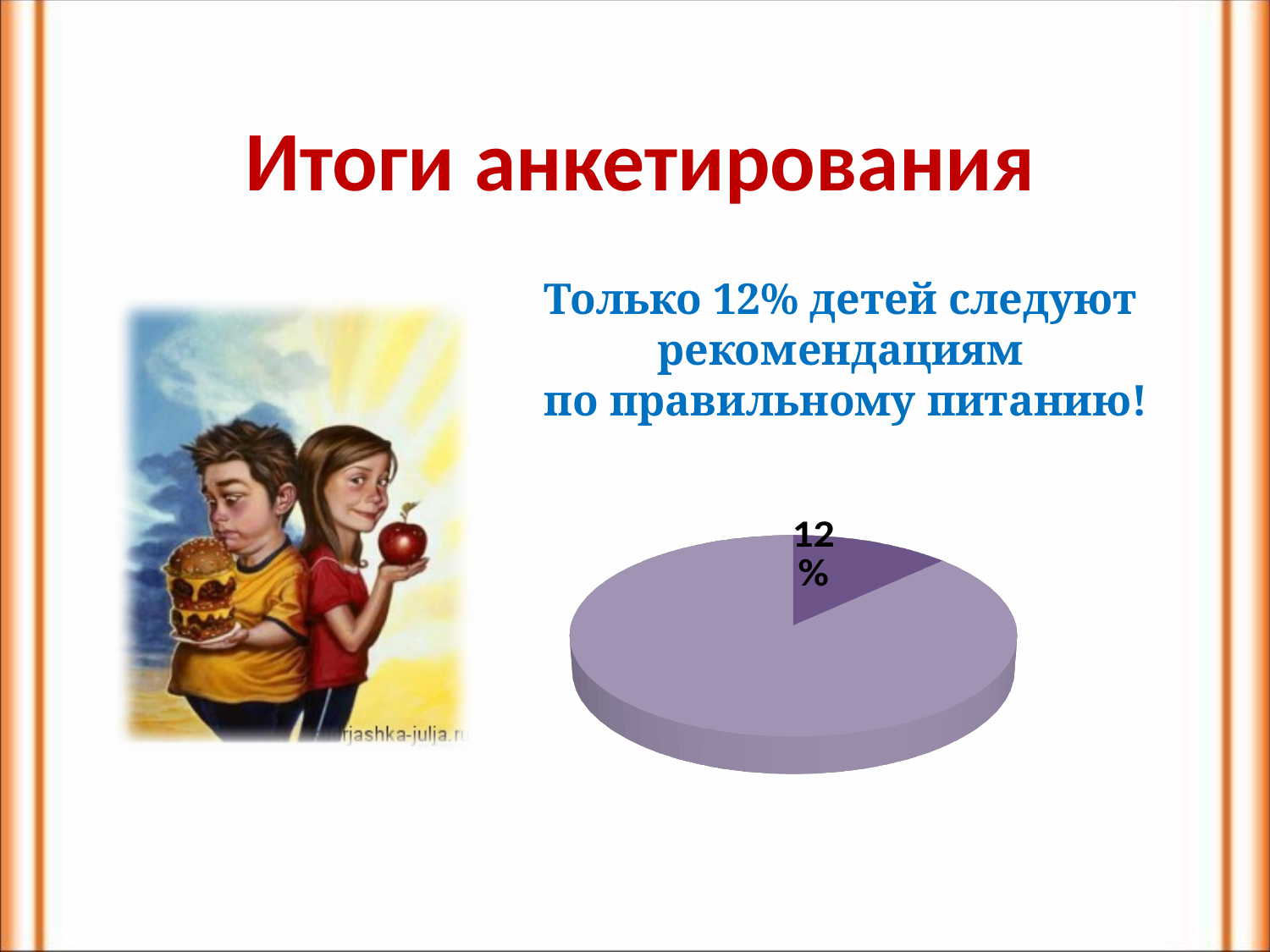
Which slice of the pie chart is larger, the dark purple one or the light purple one? the light purple one Which slice of the pie chart is the smallest? the dark purple slice labeled 12% Does the pie chart have a legend? No How many data labels are printed on the pie chart? 1 How many slices does the pie chart have? 2 What value is printed on the dark purple slice of the pie chart? 12% What kind of chart is shown on the slide? pie chart What share of the pie does the smaller slice represent? 12%